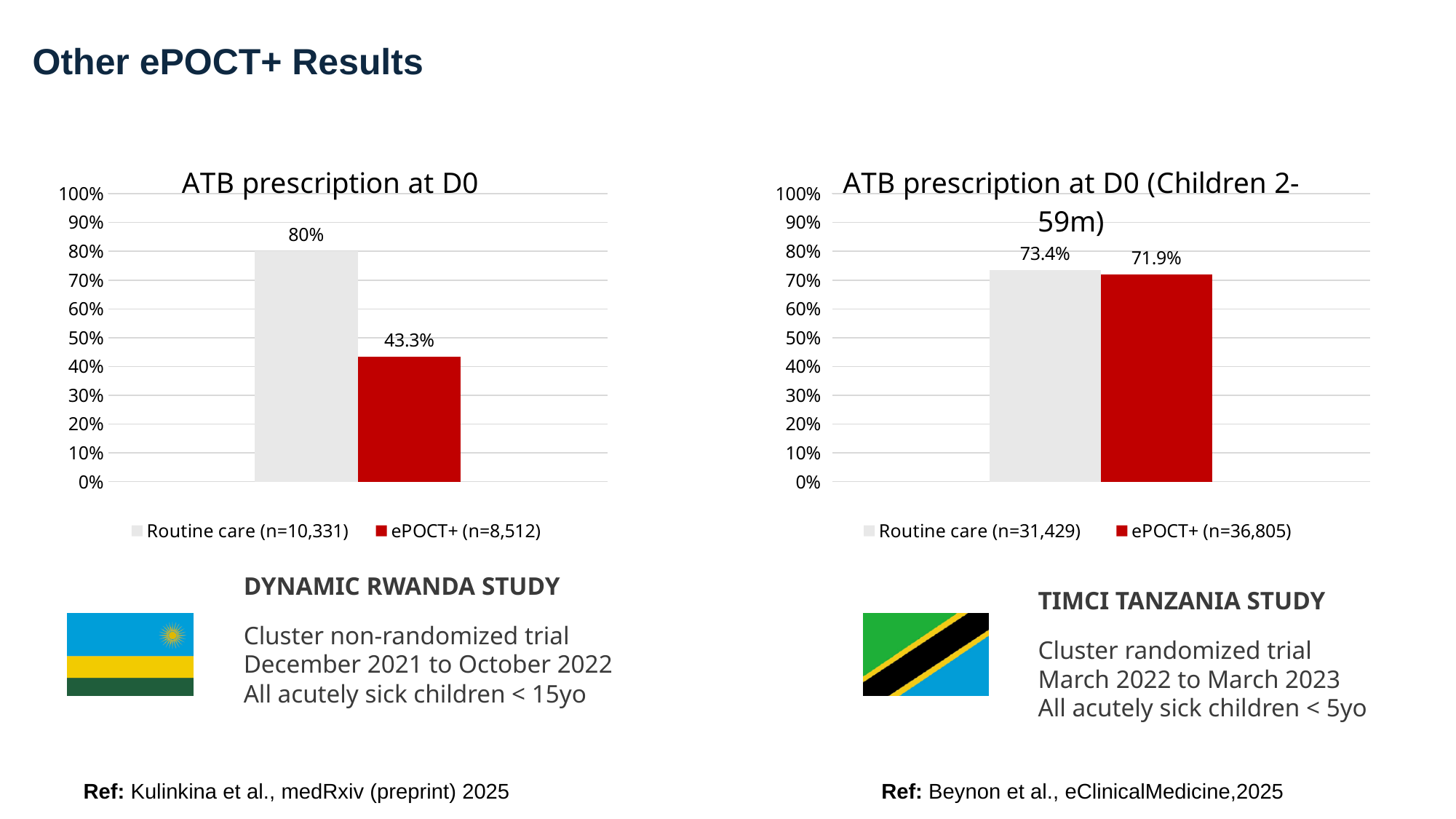
In the right chart 'ATB prescription at D0 (Children 2-59m)', what colour is the ePOCT+ bar? Red In the left chart 'ATB prescription at D0', what is the value for Routine care (n=10,331)? 80% In the right chart 'ATB prescription at D0 (Children 2-59m)', what is the value for Routine care (n=31,429)? 73.4% In the left chart 'ATB prescription at D0', what is the value for ePOCT+ (n=8,512)? 43.3% In the right chart 'ATB prescription at D0 (Children 2-59m)', what is the difference between the Routine care and ePOCT+ values? 1.5% In the right chart 'ATB prescription at D0 (Children 2-59m)', what is the value for ePOCT+ (n=36,805)? 71.9% In the left chart 'ATB prescription at D0', what is the difference between the Routine care and ePOCT+ values? 36.7% What kind of chart is the right chart 'ATB prescription at D0 (Children 2-59m)'? Bar chart In the left chart 'ATB prescription at D0', is the value for ePOCT+ greater or less than 50%? less In the left chart 'ATB prescription at D0', which series has the higher value? Routine care (n=10,331) How many series does the legend of the left chart 'ATB prescription at D0' list? 2 In the right chart 'ATB prescription at D0 (Children 2-59m)', is the value for Routine care greater or less than 70%? greater